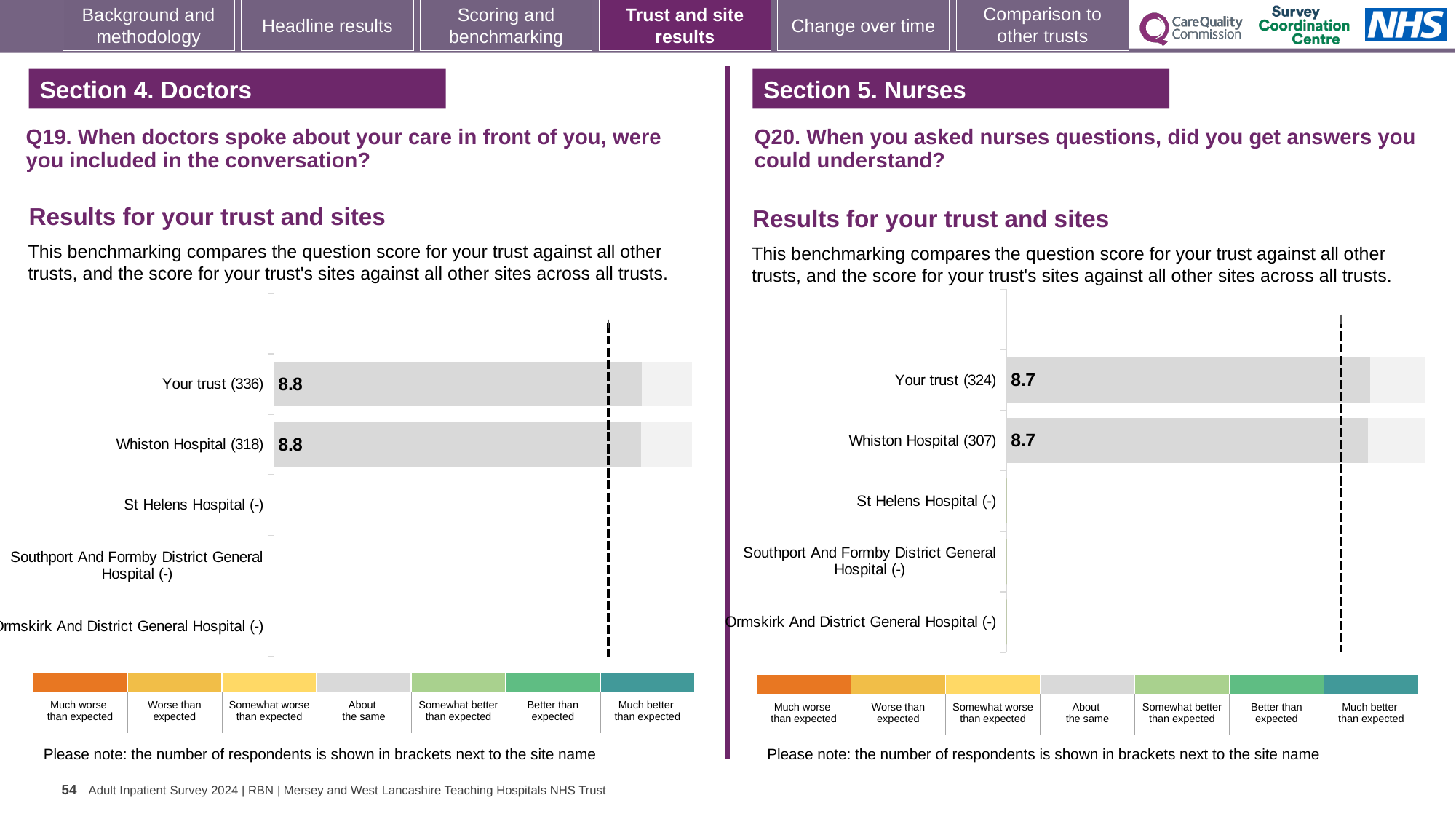
How many sites or categories are listed on the y axis of the Q19 chart on the left? 5 In the Q20 chart on the right, how many sites have a score bar plotted? 2 What kind of chart is the Q19 chart on the left? Bar chart In the Q19 chart on the left, how many respondents are shown in brackets for Whiston Hospital? 318 In the Q19 chart on the left, what is the score for Your trust (336)? 8.8 How many sites or categories are listed on the y axis of the Q20 chart on the right? 5 In the Q20 chart on the right, what is the score for Your trust (324)? 8.7 How many benchmark bands are shown in the colour key below the Q20 chart on the right? 7 In the Q19 chart on the left, what is the score for Whiston Hospital (318)? 8.8 In the Q19 chart on the left, what is the difference between the scores for Your trust and Whiston Hospital? 0 In the Q20 chart on the right, what is the score for Whiston Hospital (307)? 8.7 In the Q20 chart on the right, what is the difference between the scores for Your trust and Whiston Hospital? 0